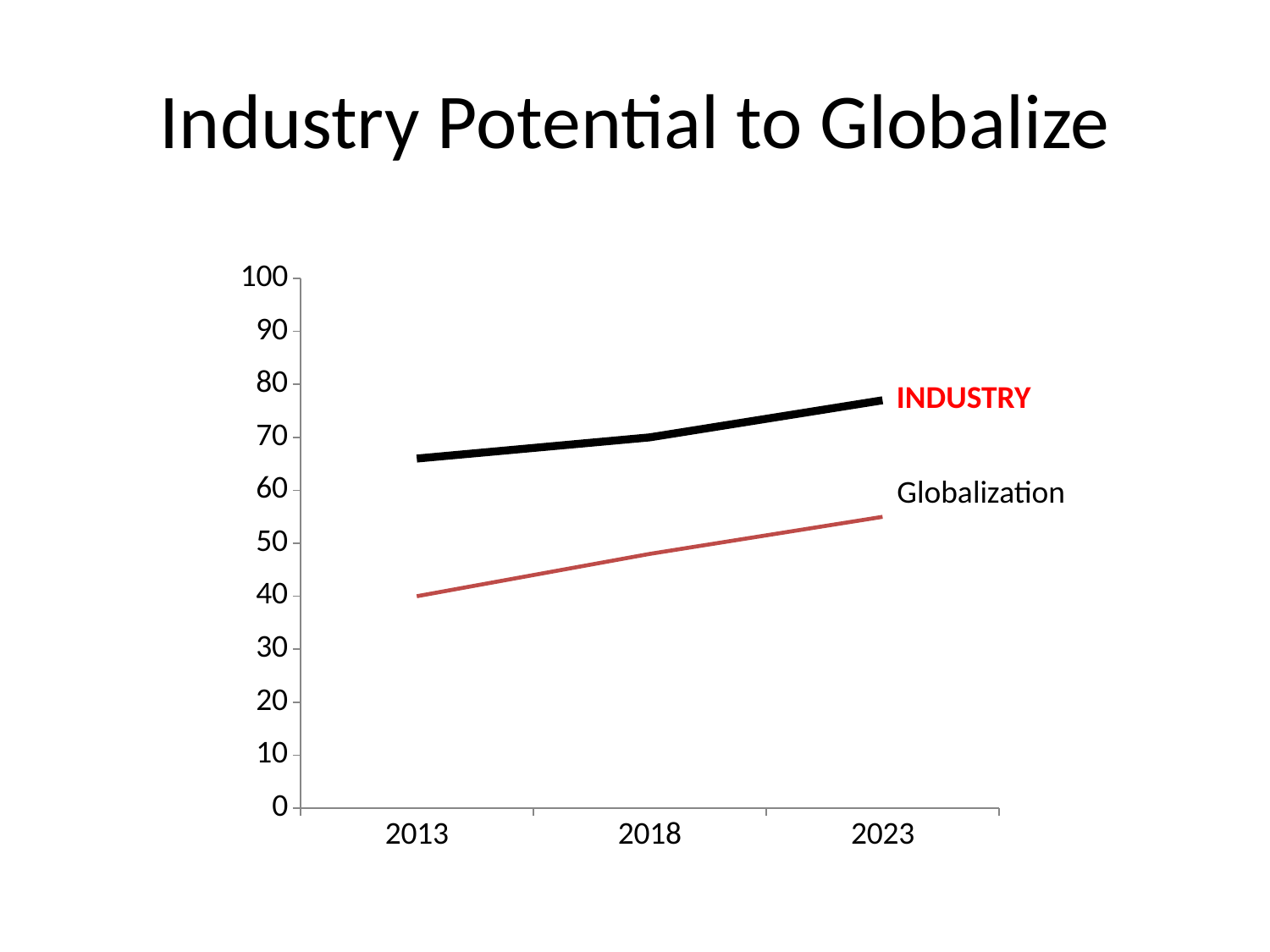
Do the values for Globalization rise or fall from 2013 to 2023? rise How many years are shown on the x axis? 3 What is the value for Globalization in 2013? 40 What kind of chart is shown on the slide? line chart What is the title of the slide's chart? Industry Potential to Globalize Is the value for Globalization in 2018 greater or less than 40? greater How many series are plotted on the chart? 2 Which series has the higher value in 2023, INDUSTRY or Globalization? INDUSTRY Which series is drawn with the thick black line? INDUSTRY Is the value for INDUSTRY in 2023 greater or less than 70? greater Is the value for Globalization in 2023 greater or less than 60? less